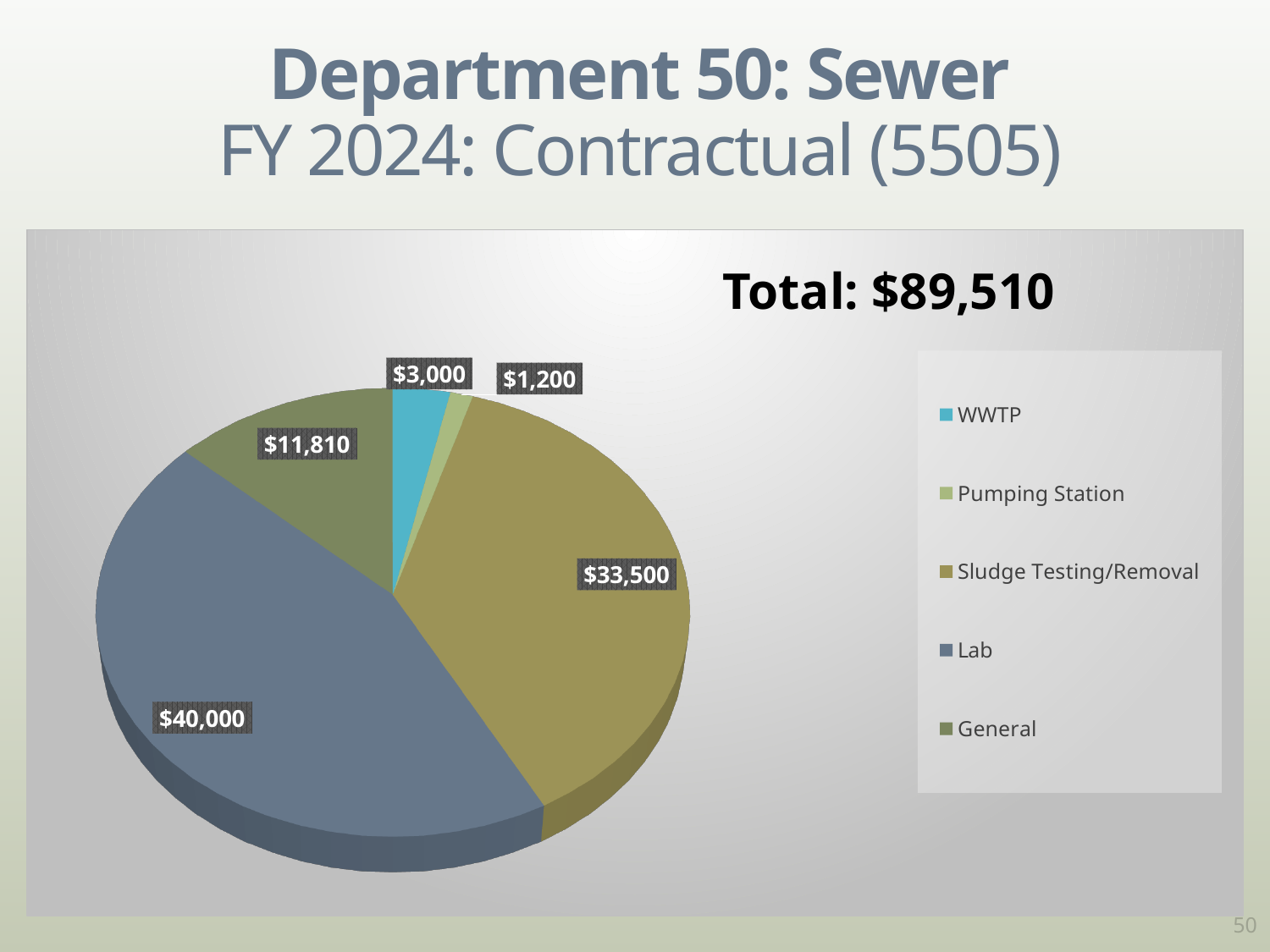
What is the value for Lab? $40,000 Which is larger, the value for General or the value for WWTP? General How many categories does the pie chart show? 5 What is the value for WWTP? $3,000 Which category has the smallest slice of the pie? Pumping Station Which category has the largest slice of the pie? Lab What is the value for Sludge Testing/Removal? $33,500 What is the value for General? $11,810 What total is stated on the slide for the pie chart? $89,510 What kind of chart is shown on the slide? Pie chart What is the difference between the Lab value and the Sludge Testing/Removal value? $6,500 What is the value for Pumping Station? $1,200